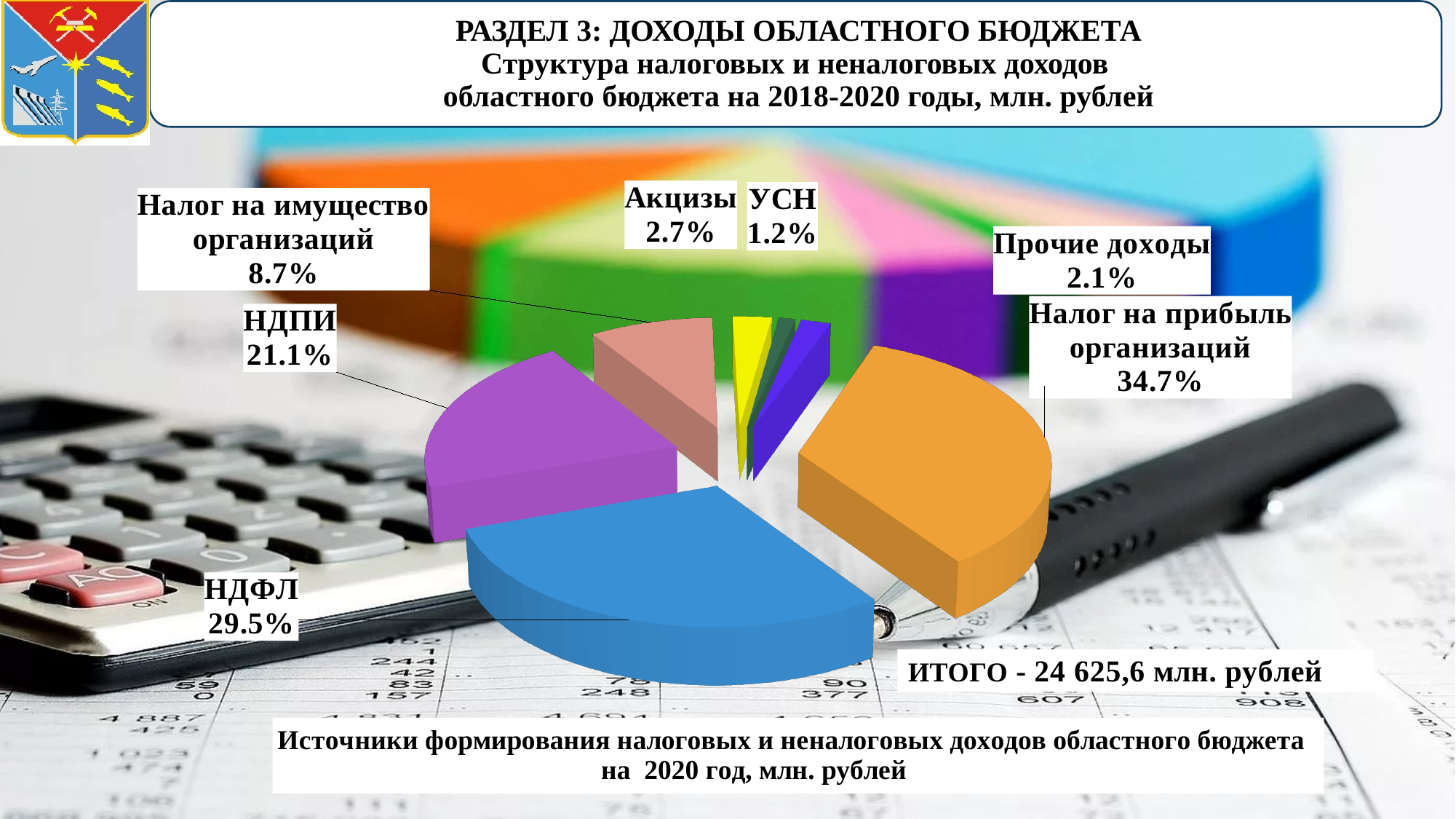
What share of the pie does НДПИ have? 21.1% What share of the pie does УСН have? 1.2% How many slices does the pie chart have? 7 Which category has the smallest share of the pie? УСН What total amount (ИТОГО) is stated on the slide for the 2020 revenues? 24 625,6 млн. рублей What share of the pie does НДФЛ have? 29.5% What kind of chart is shown on the slide? pie chart Which category has the largest share of the pie? Налог на прибыль организаций Which is larger, the share for Акцизы or the share for Прочие доходы? Акцизы What is the difference in percentage points between Налог на прибыль организаций and НДФЛ? 5.2 What share of the pie does Налог на имущество организаций have? 8.7% What share of the pie does Налог на прибыль организаций have? 34.7%